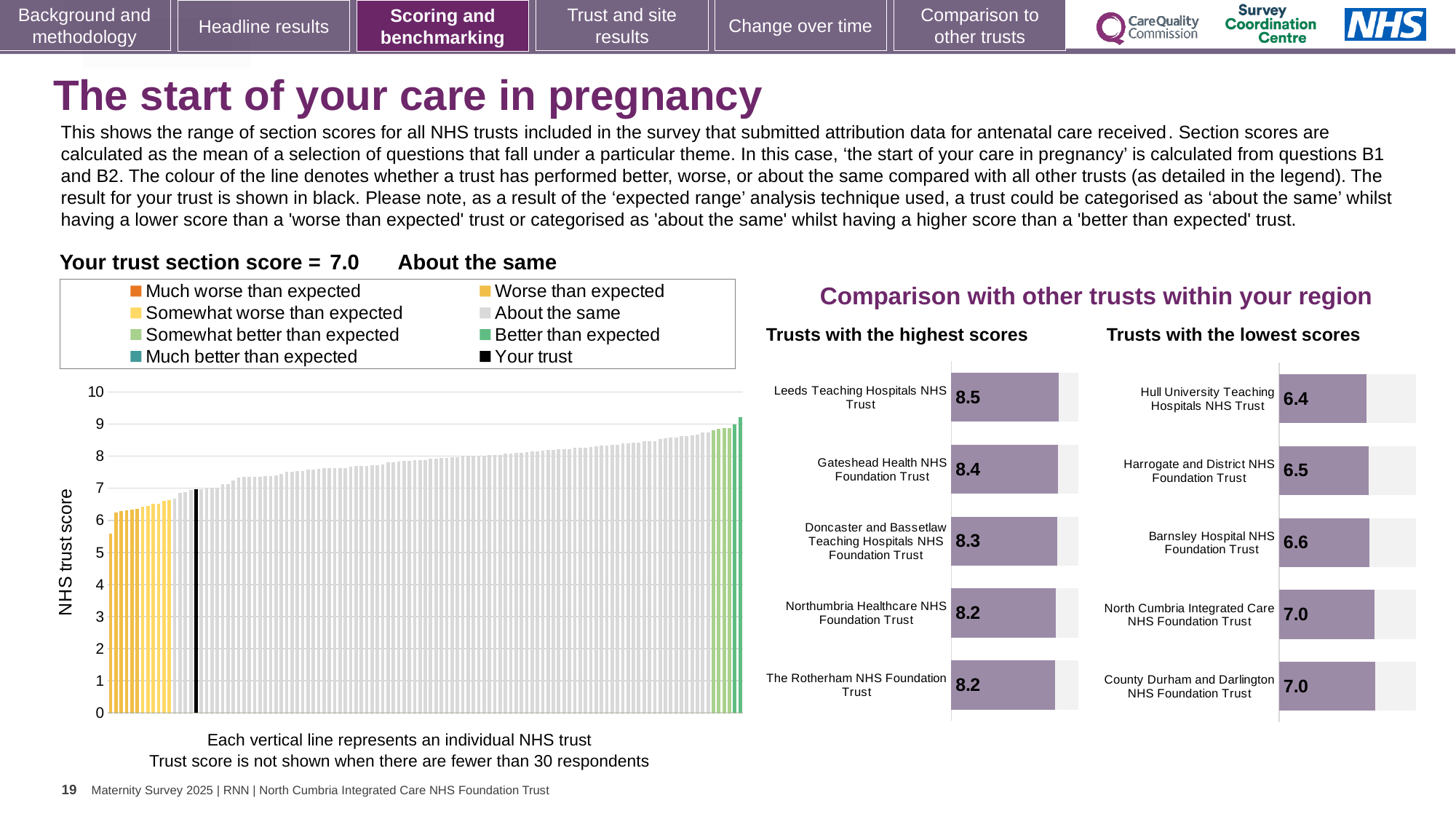
How many trusts are shown in the 'Trusts with the lowest scores' chart? 5 In the 'Trusts with the highest scores' chart, what is the score for Leeds Teaching Hospitals NHS Trust? 8.5 In the large chart on the left, is the value of the leftmost bar greater or less than 6? less What is the difference between the score for Leeds Teaching Hospitals NHS Trust in the 'Trusts with the highest scores' chart and the score for Hull University Teaching Hospitals NHS Trust in the 'Trusts with the lowest scores' chart? 2.1 In the 'Trusts with the lowest scores' chart, which trust has the lowest score? Hull University Teaching Hospitals NHS Trust In the 'Trusts with the lowest scores' chart, what is the score for Hull University Teaching Hospitals NHS Trust? 6.4 In the large chart on the left, what is the section score for your trust (the black bar)? 7.0 In the 'Trusts with the highest scores' chart, which trust has the highest score? Leeds Teaching Hospitals NHS Trust How many entries does the legend above the large chart on the left list? 8 In the 'Trusts with the highest scores' chart, which is larger: the score for Gateshead Health NHS Foundation Trust or the score for Northumbria Healthcare NHS Foundation Trust? Gateshead Health NHS Foundation Trust In the 'Trusts with the lowest scores' chart, what is the score for Barnsley Hospital NHS Foundation Trust? 6.6 In the large chart on the left, do the trust scores rise or fall from left to right? rise